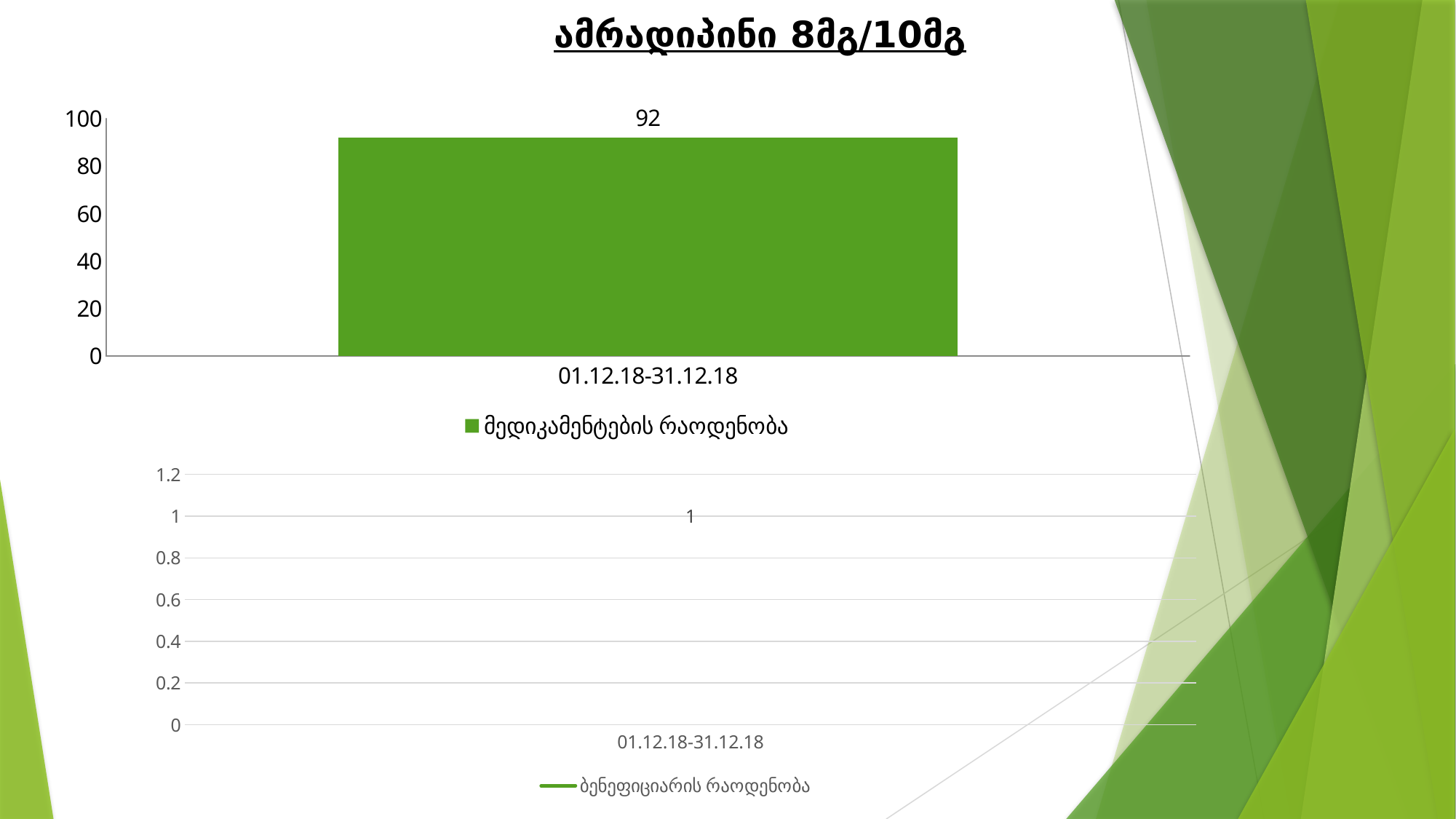
How many series does the legend of the top chart list? 1 How many categories are shown on the x axis of the top chart? 1 What kind of chart is the top chart? bar chart In the bottom chart, what is the value for 01.12.18-31.12.18? 1 In the bottom chart, is the value for 01.12.18-31.12.18 greater or less than 0.8? greater In the top chart, is the value for 01.12.18-31.12.18 greater or less than 80? greater How many data points are plotted in the bottom chart? 1 What is the title shown above the top chart? ამრადიპინი 8მგ/10მგ How many series does the legend of the bottom chart list? 1 What series name appears in the legend of the bottom chart? ბენეფიციარის რაოდენობა What kind of chart is the bottom chart? line chart In the top chart, what is the value for 01.12.18-31.12.18? 92